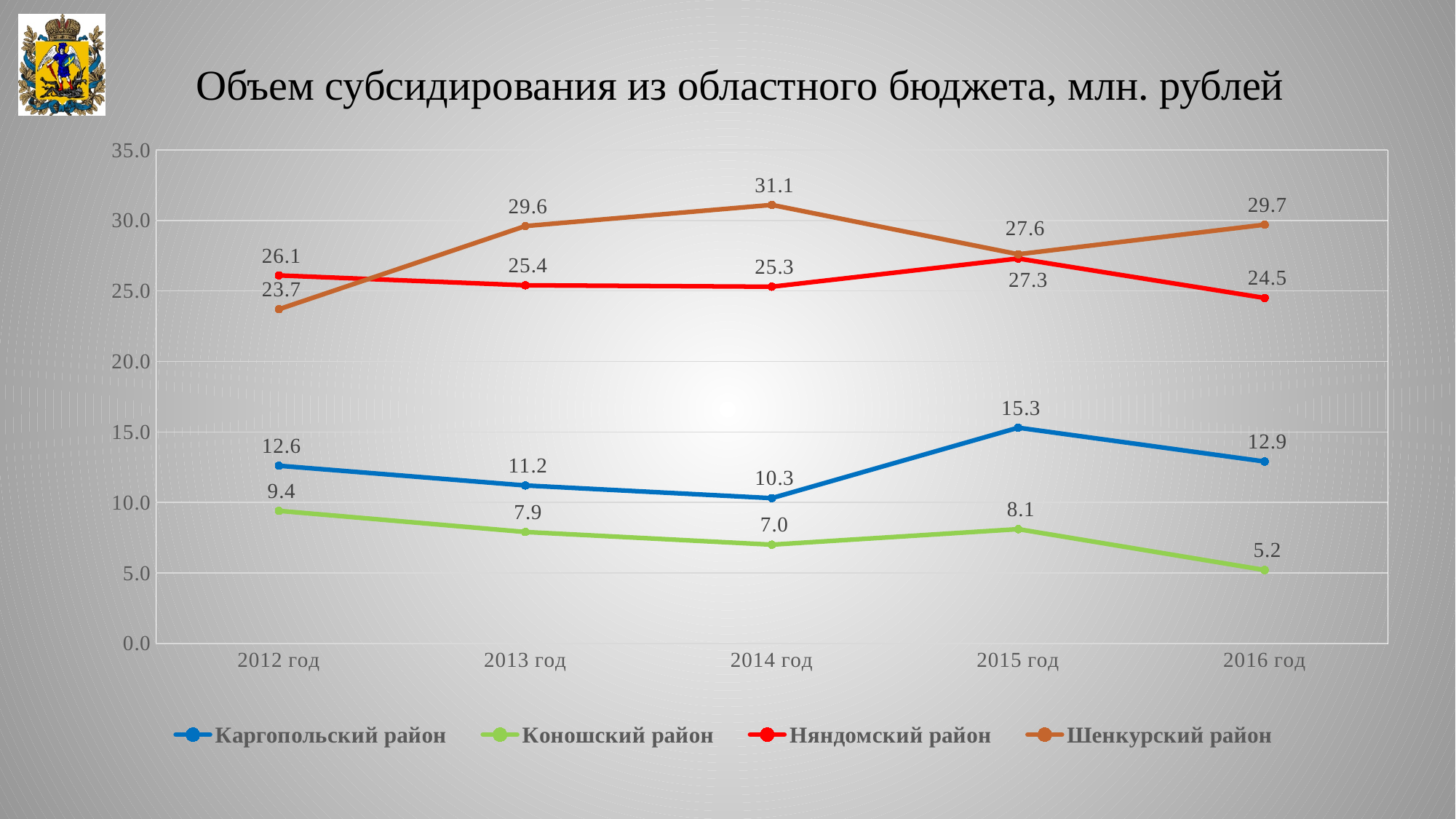
What is the value for Няндомский район in 2012 год? 26.1 What is the difference between the values for Шенкурский район and Няндомский район in 2016 год? 5.2 How many years are shown on the x axis? 5 What is the value for Шенкурский район in 2014 год? 31.1 How many series does the legend list? 4 What is the value for Коношский район in 2016 год? 5.2 In which year is the value for Коношский район lowest? 2016 год What type of chart is shown on the slide? line chart What is the value for Каргопольский район in 2015 год? 15.3 Which is larger in 2012 год: Няндомский район or Шенкурский район? Няндомский район Does the value for Коношский район rise or fall from 2015 год to 2016 год? fall In which year is the value for Шенкурский район highest? 2014 год